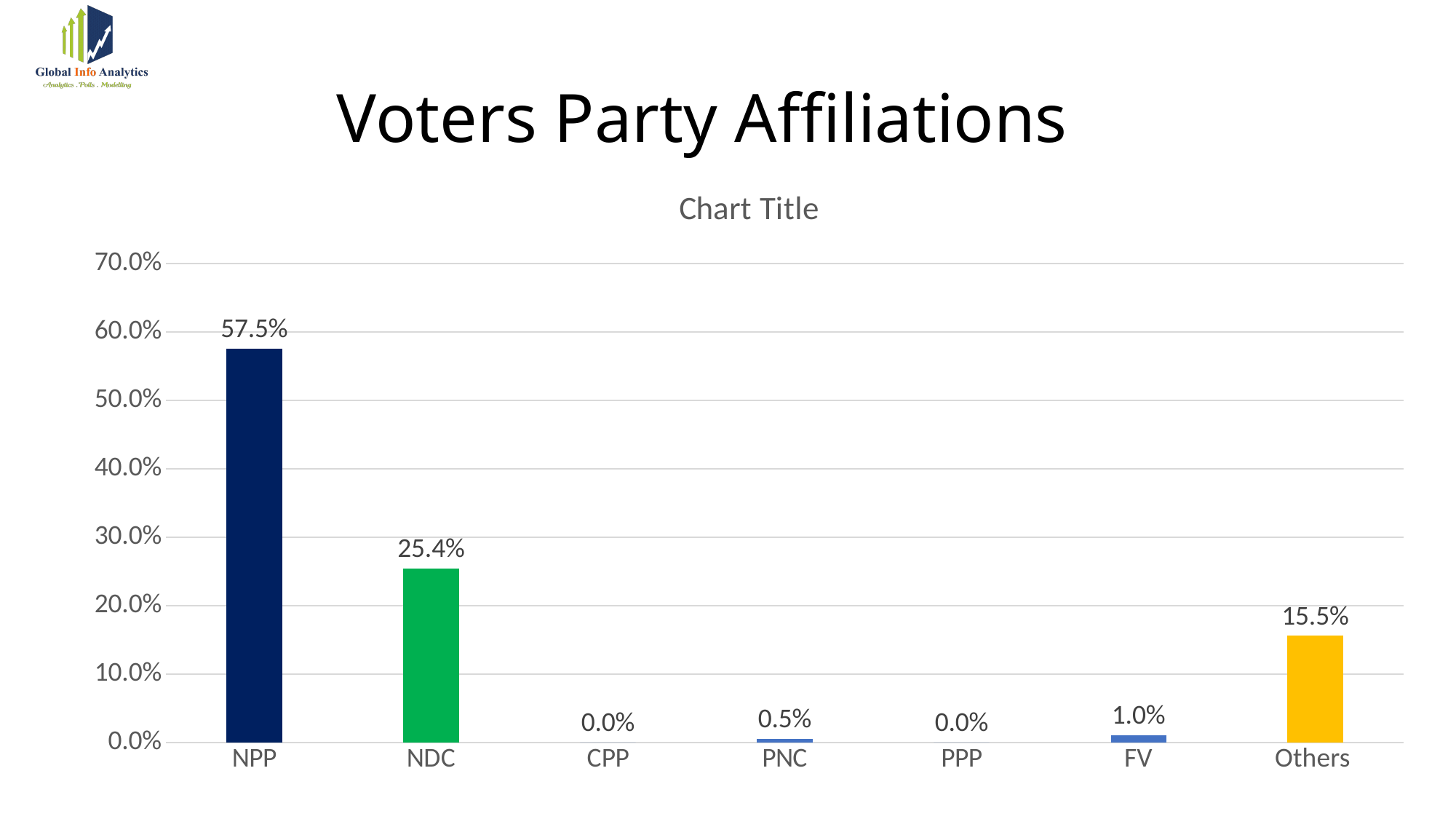
How many categories are shown on the x axis? 7 What is the value for Others? 15.5% What is the value for NDC? 25.4% What is the difference between the values for NDC and Others? 9.9% What is the title of the slide? Voters Party Affiliations Which party has the highest value? NPP What is the value for NPP? 57.5% Which is larger, the value for NDC or the value for Others? NDC What kind of chart is shown on the slide? Bar chart What is the value for PNC? 0.5% What is the difference between the values for NPP and NDC? 32.1% What is the value for FV? 1.0%